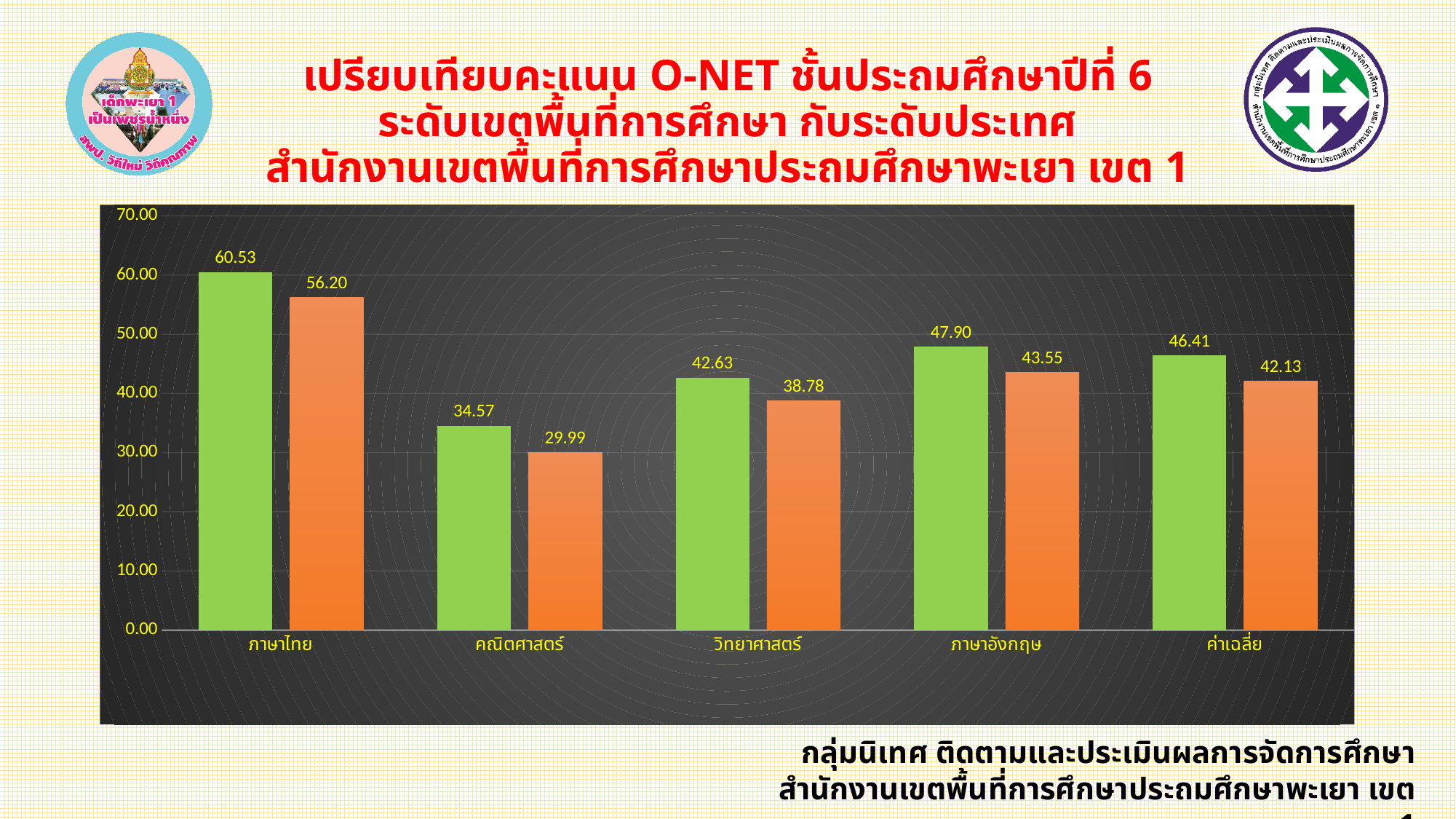
What is the value of the orange bar for คณิตศาสตร์? 29.99 What two colours are used for the bars in the chart? green and orange What is the value of the green bar for ภาษาไทย? 60.53 What is the value of the orange bar for ค่าเฉลี่ย? 42.13 Is the orange bar for วิทยาศาสตร์ greater or less than 40.00? less What kind of chart is shown on the slide? bar chart Which category has the highest green bar? ภาษาไทย How many categories are shown on the x axis? 5 Which category has the lowest orange bar? คณิตศาสตร์ What is the value of the green bar for วิทยาศาสตร์? 42.63 What is the difference between the green and orange bars for ภาษาอังกฤษ? 4.35 Which is larger for คณิตศาสตร์, the green bar or the orange bar? the green bar